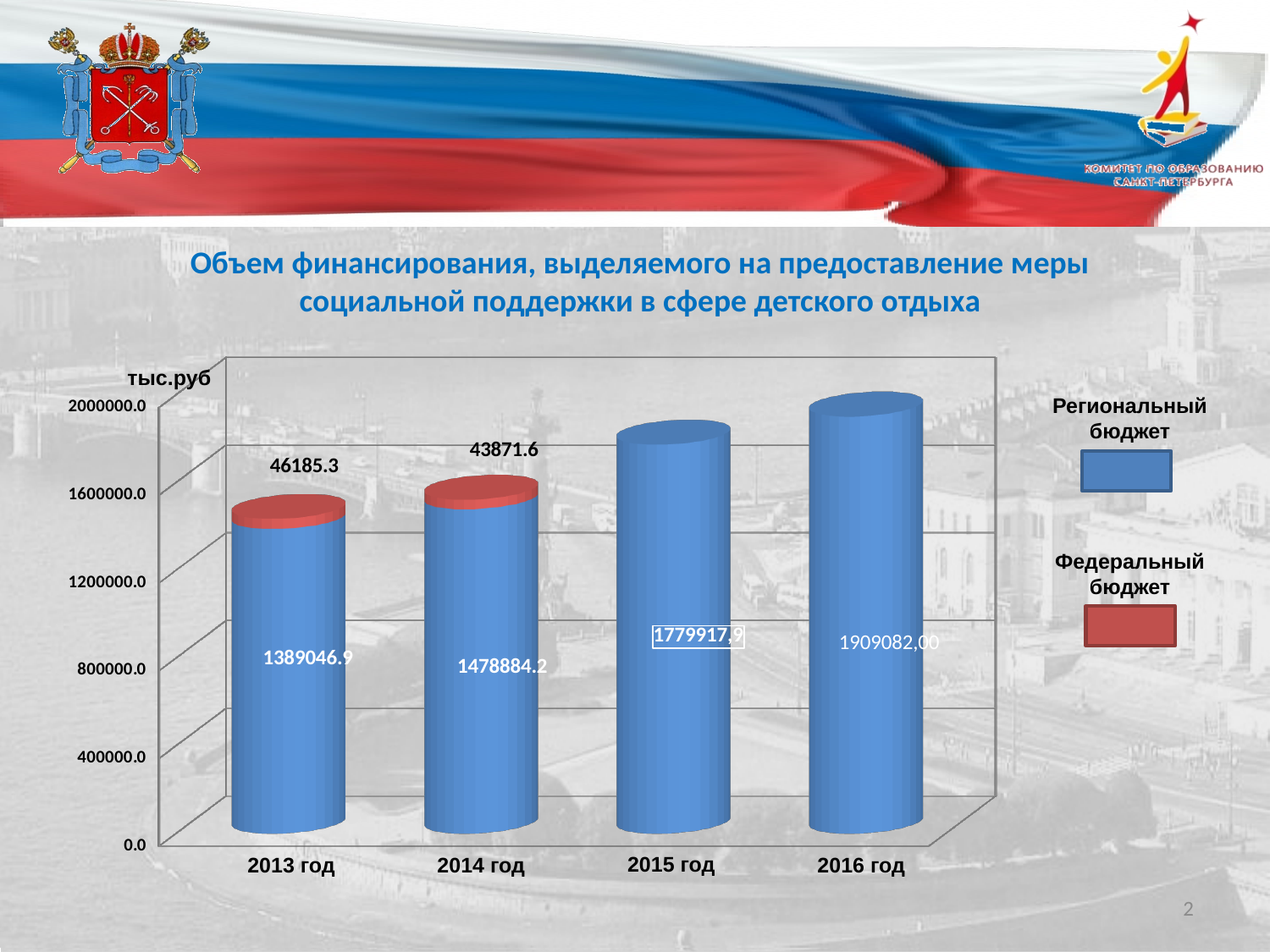
Which year has the highest value for the Региональный бюджет series? 2016 год Is the Региональный бюджет value for 2015 год greater or less than 1600000.0? greater How many years are shown on the x axis of the chart? 4 Which year has the lowest value for the Региональный бюджет series? 2013 год What is the total of the stacked bar for 2013 год? 1435232.2 How many series does the legend list? 2 What is the difference between the Региональный бюджет values for 2014 год and 2013 год? 89837.3 What kind of chart is shown on the slide? bar chart Which is larger: the Федеральный бюджет value for 2013 год or for 2014 год? 2013 год What is the value of the Региональный бюджет series for 2013 год? 1389046.9 What is the value of the Региональный бюджет series for 2016 год? 1909082,00 What is the value of the Федеральный бюджет series for 2014 год? 43871.6